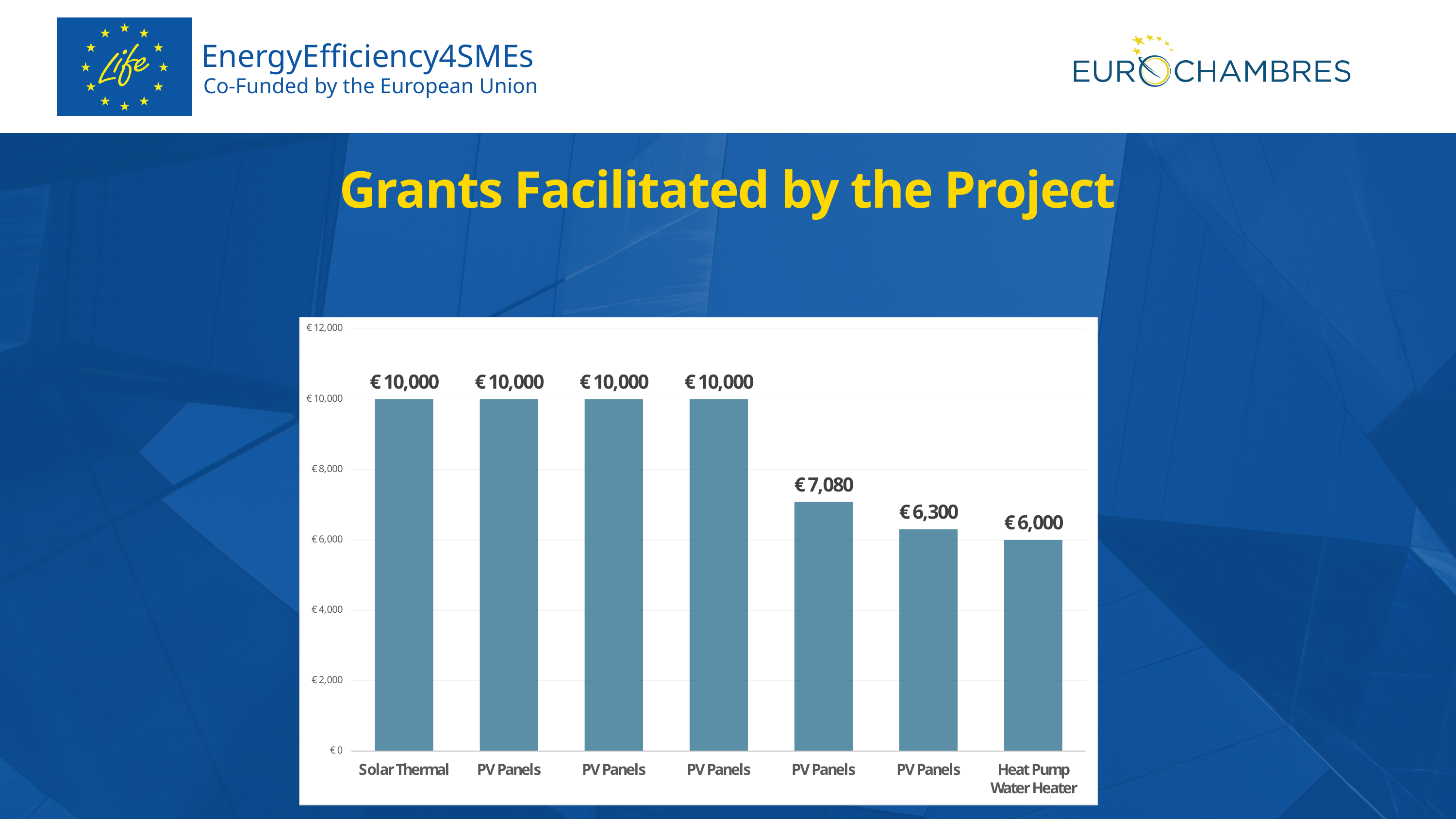
How many bars are shown in the chart? 7 What is the difference between the fifth bar (€ 7,080) and the sixth bar (€ 6,300)? € 780 What is the grant value shown for Heat Pump Water Heater? € 6,000 What kind of chart is shown on the slide? bar chart Is the value for Heat Pump Water Heater larger or smaller than the value of the sixth bar from the left (PV Panels)? smaller What is the value of the sixth bar from the left (PV Panels)? € 6,300 What is the grant value shown for Solar Thermal? € 10,000 What is the difference between the Solar Thermal grant and the Heat Pump Water Heater grant? € 4,000 Which category has the lowest grant value? Heat Pump Water Heater Is the value for Heat Pump Water Heater greater or less than 8,000? less What is the value of the fifth bar from the left (PV Panels)? € 7,080 How many bars are labelled PV Panels? 5